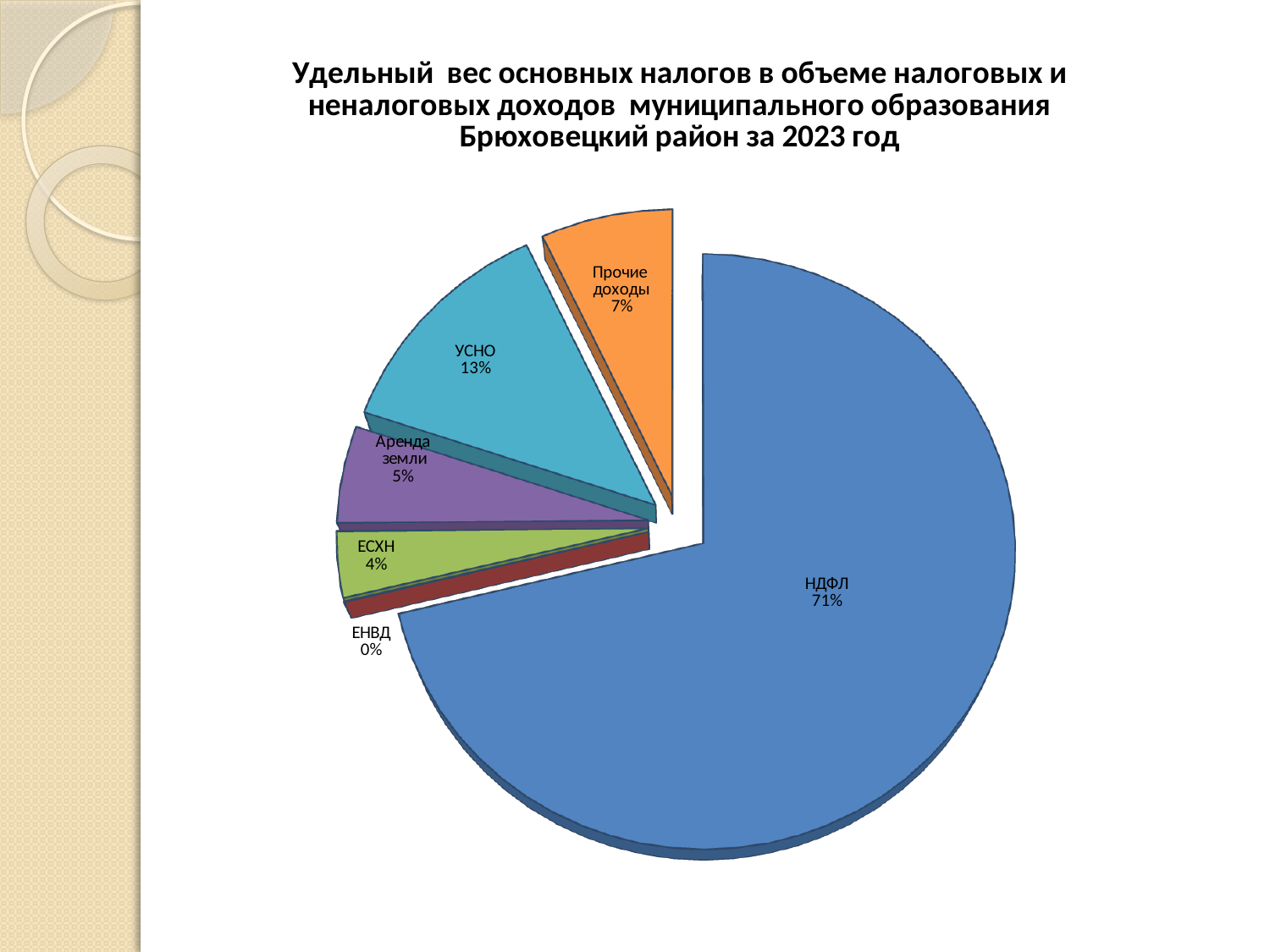
What is the value shown for УСНО? 13% What is the value shown for ЕНВД? 0% Which category has the largest slice of the pie? НДФЛ What is the difference in percentage points between НДФЛ and УСНО? 58 Which category has the smallest slice of the pie? ЕНВД Which is larger, УСНО or Прочие доходы? УСНО What is the value shown for Прочие доходы? 7% What is the value shown for ЕСХН? 4% What is the value shown for Аренда земли? 5% What type of chart is shown on the slide? Pie chart What share of the pie does НДФЛ have? 71% How many categories are shown in the pie chart? 6